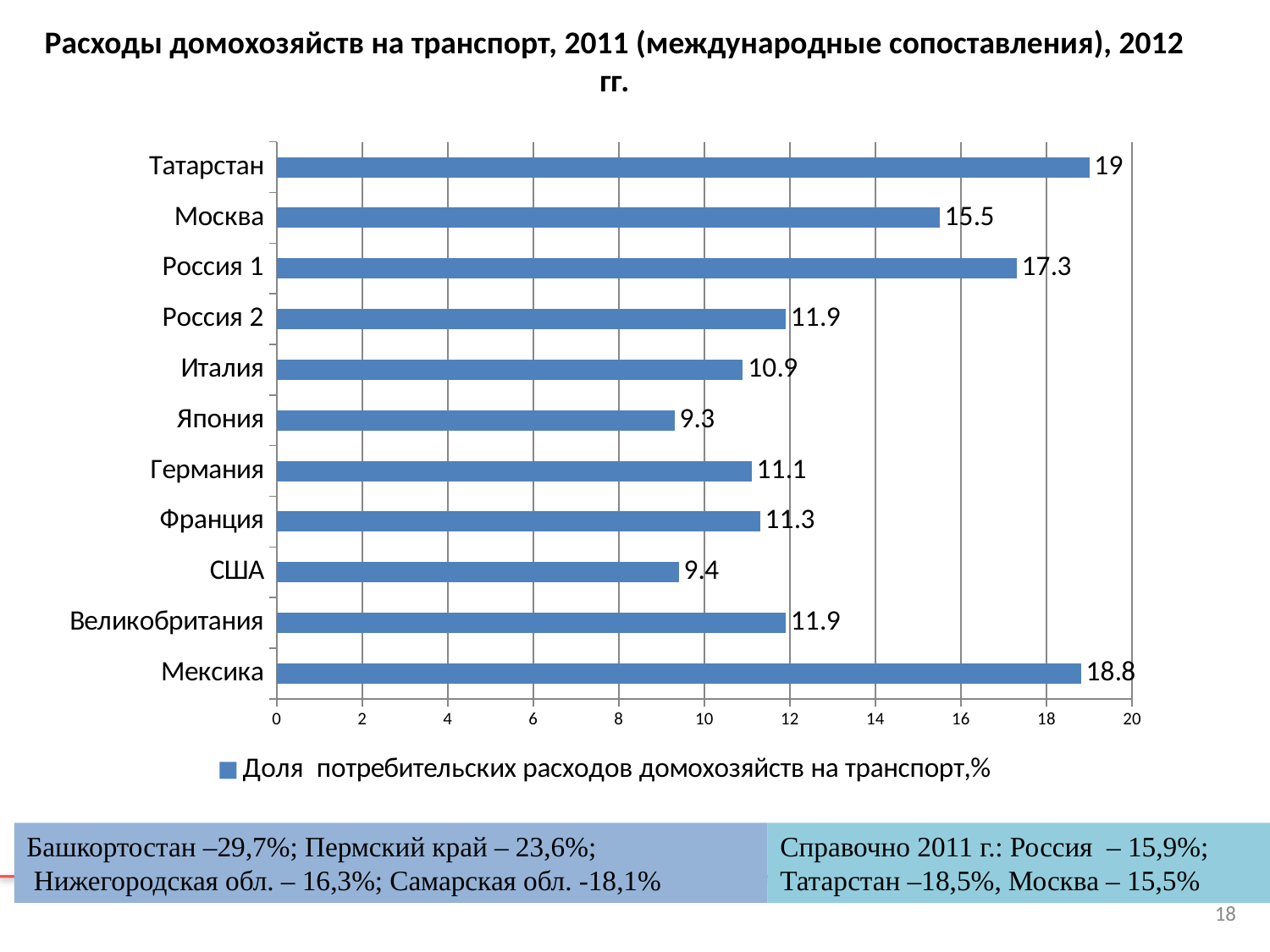
How many series does the legend list? 1 What is the value for Япония? 9.3 Which is larger, the value for Германия or the value for Франция? Франция Is the value for Италия greater or less than 10? greater Which category has the lowest value? Япония What is the legend entry of the chart? Доля потребительских расходов домохозяйств на транспорт,% Which category has the highest value? Татарстан How many categories are shown in the chart? 11 What is the value for Мексика? 18.8 What is the value for Татарстан? 19 What is the difference between the values for Россия 1 and Москва? 1.8 What kind of chart is shown on the slide? bar chart